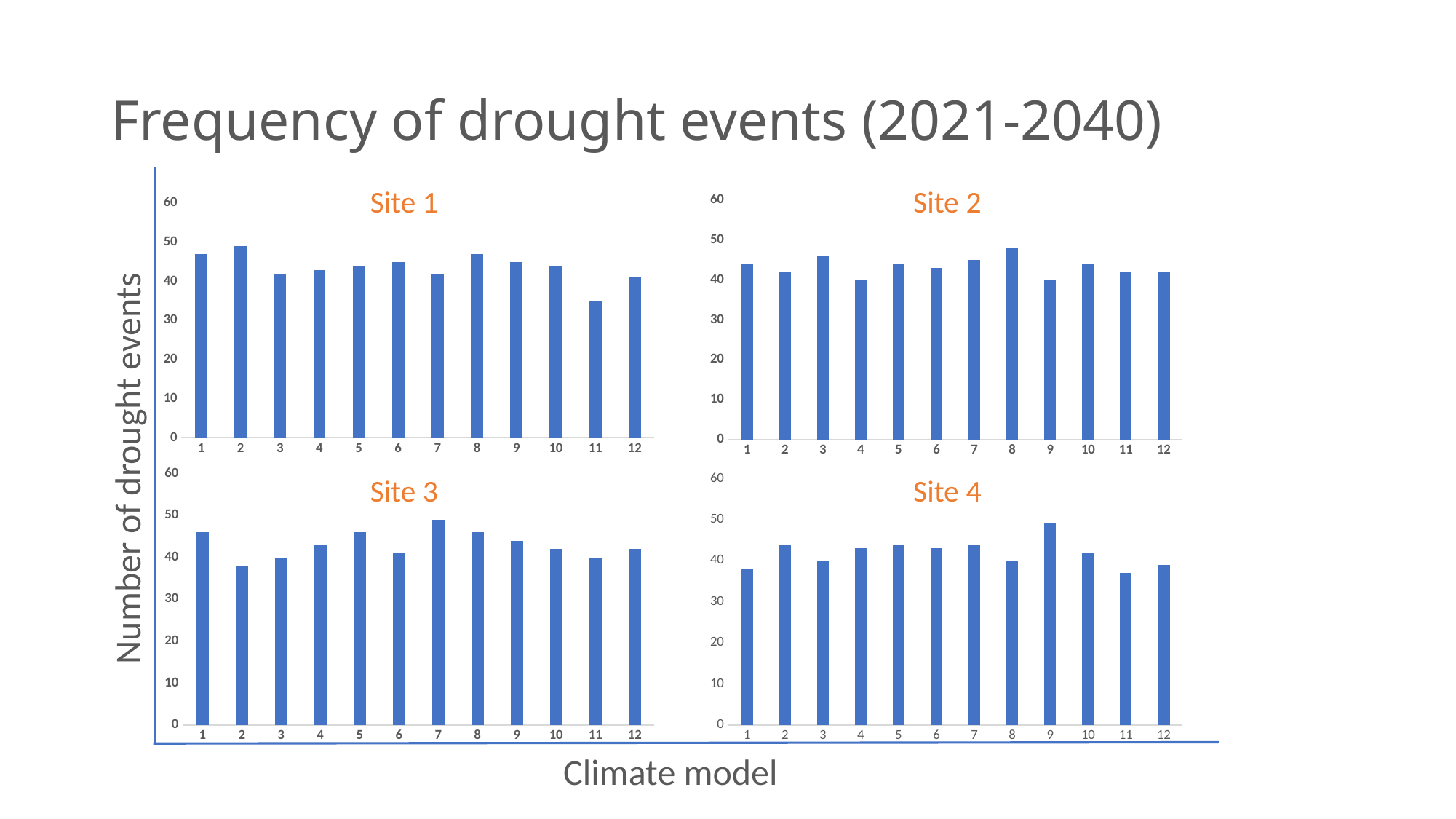
In the Site 2 chart, is the value for climate model 8 greater or less than 40? greater In the Site 1 chart, which climate model has the lowest number of drought events? 11 In the Site 4 chart, which climate model has the highest number of drought events? 9 In the Site 3 chart, which climate model has the highest number of drought events? 7 In the Site 2 chart, which climate model has the highest number of drought events? 8 How many climate models are shown in the Site 3 chart? 12 What is the label on the shared vertical axis of the charts? Number of drought events In the Site 1 chart, is the value for climate model 11 greater or less than 40? less In the Site 4 chart, which has more drought events: climate model 9 or climate model 11? climate model 9 What kind of chart is used for Site 2? bar chart In the Site 4 chart, is the value for climate model 1 greater or less than 40? less